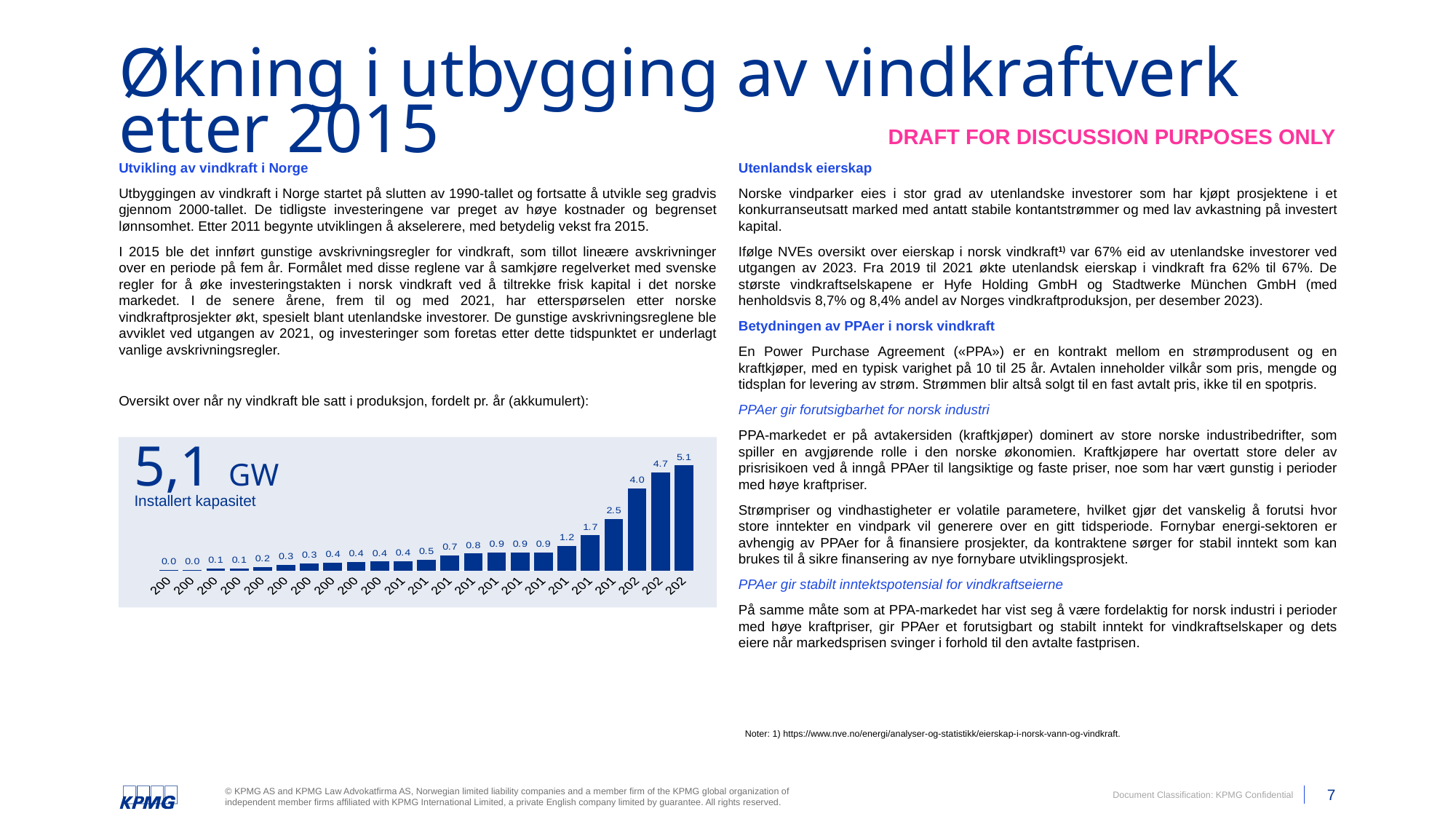
What is the value of the first (leftmost) bar in the chart? 0.0 Which is larger: the third-from-last bar or the fourth-from-last bar? the third-from-last bar (4.0) What label appears beneath the large figure in the chart area? Installert kapasitet What type of chart is shown on the slide? bar chart What is the value of the second-to-last bar in the chart? 4.7 What large figure is displayed in the top-left corner of the chart area? 5,1 GW How many bars are plotted in the chart? 23 What is the difference between the bar labelled 4.0 and the bar labelled 2.5? 1.5 What is the highest value shown in the chart? 5.1 What is the difference between the last bar (5.1) and the second-to-last bar (4.7)? 0.4 What is the value of the rightmost (last) bar in the chart? 5.1 Do the values in the chart generally rise or fall from left to right? rise